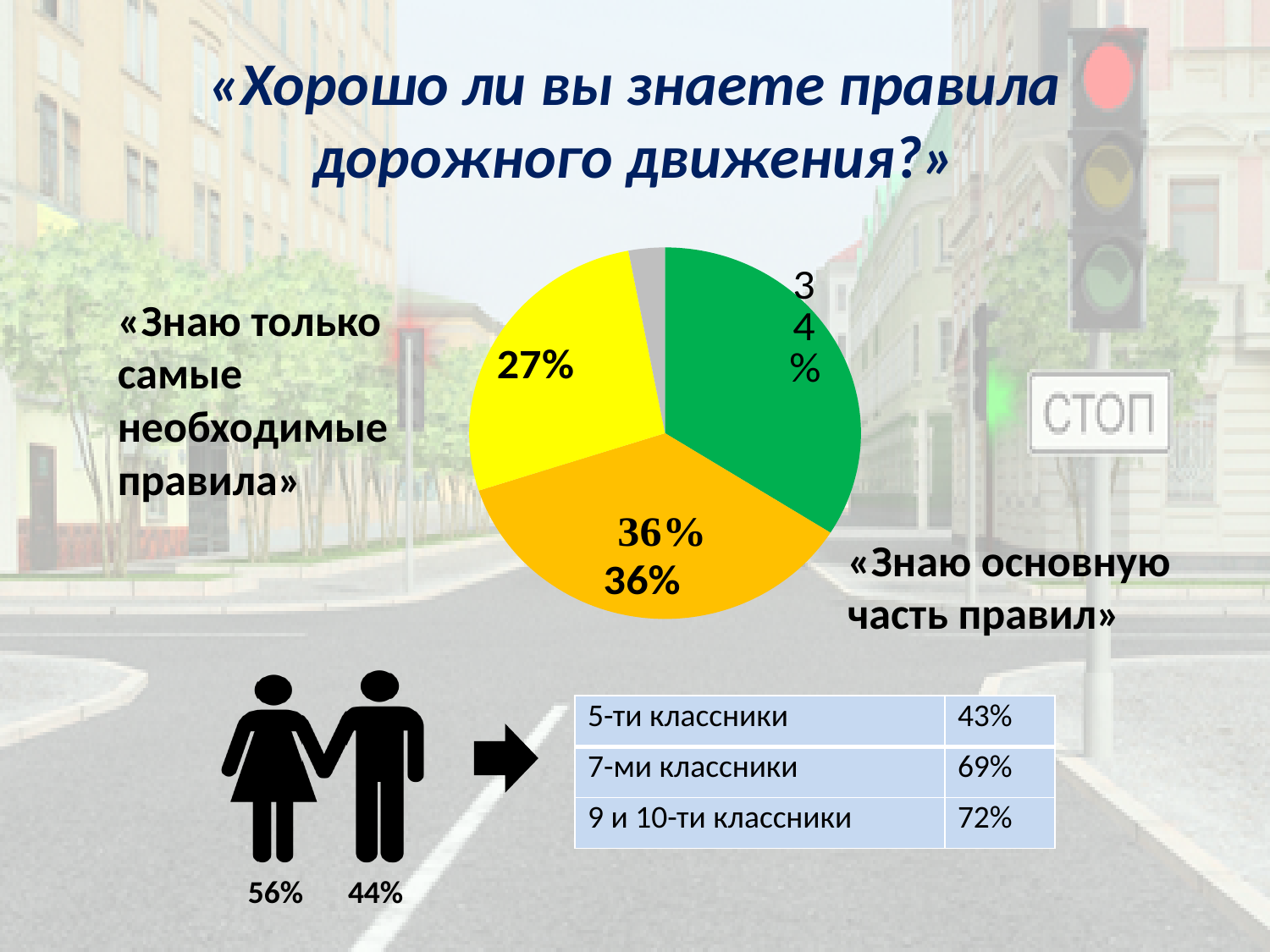
What is the difference between the orange slice (36%) and the green slice (34%) in the pie chart? 2% Which slice of the pie chart is the largest? the orange slice (36%) Which slice of the pie chart is the smallest? the grey slice What is the title of the slide containing the pie chart? «Хорошо ли вы знаете правила дорожного движения?» What percentage is shown on the orange slice of the pie chart? 36% What kind of chart is shown on the slide? pie chart What colour is the slice labelled 27% in the pie chart? yellow Which is larger in the pie chart, the green slice or the yellow slice? the green slice How many slices does the pie chart have? 4 What percentage is shown on the yellow slice of the pie chart? 27% What is the difference between the orange slice (36%) and the yellow slice (27%) in the pie chart? 9% What percentage is shown on the green slice of the pie chart? 34%